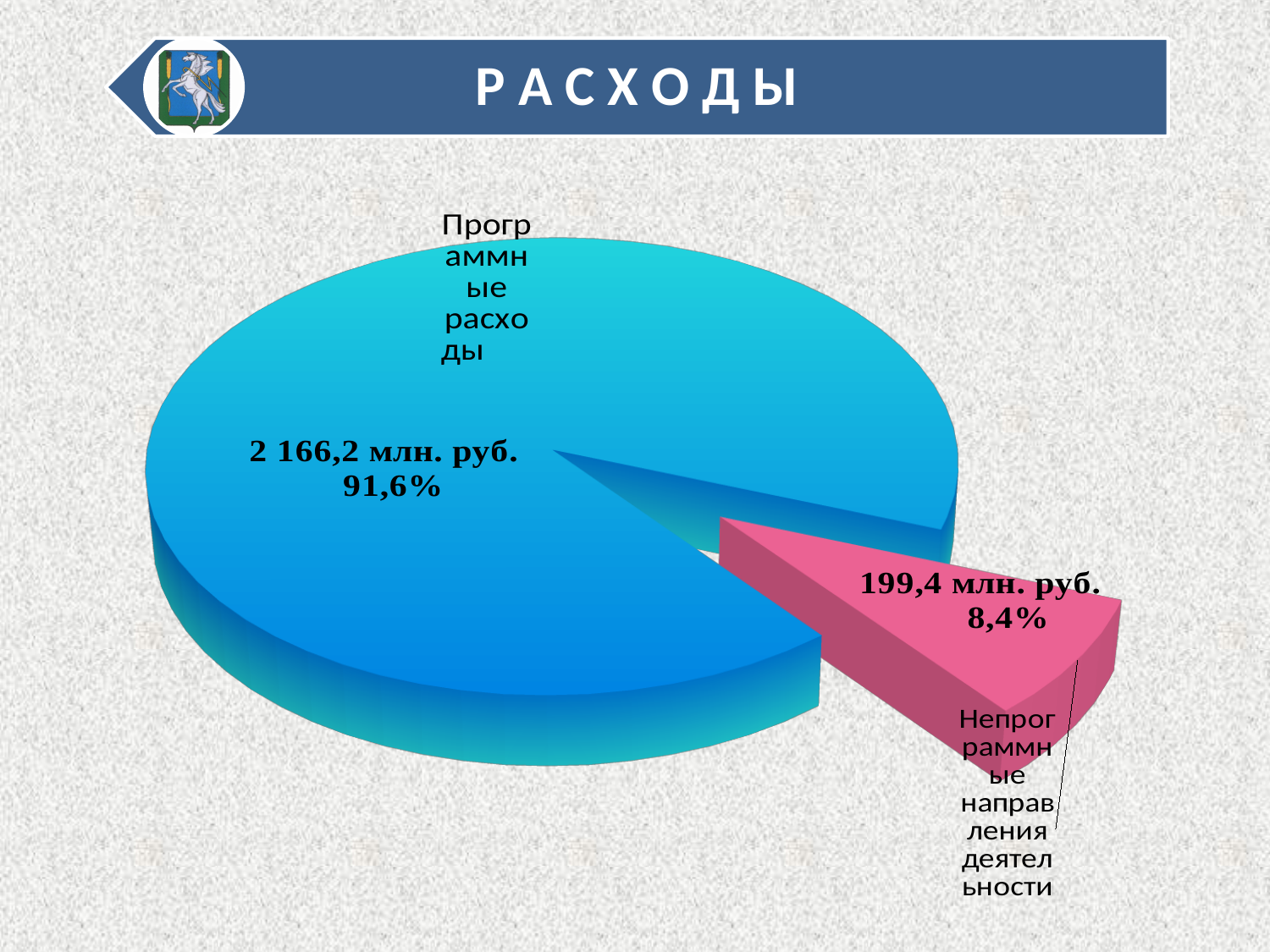
Which is larger, Программные расходы or Непрограммные направления деятельности? Программные расходы What kind of chart is shown on the slide? Pie chart What is the value for Непрограммные направления деятельности? 199,4 млн. руб. What is the value for Программные расходы? 2 166,2 млн. руб. What share of the pie does Непрограммные направления деятельности take? 8,4% Which slice is the largest? Программные расходы What is the title of the slide containing the chart? РАСХОДЫ What is the difference in млн. руб. between Программные расходы and Непрограммные направления деятельности? 1 966,8 млн. руб. What is the total of the two slices in млн. руб.? 2 365,6 млн. руб. What share of the pie does Программные расходы take? 91,6% How many slices does the pie chart have? 2 Which slice is the smallest? Непрограммные направления деятельности